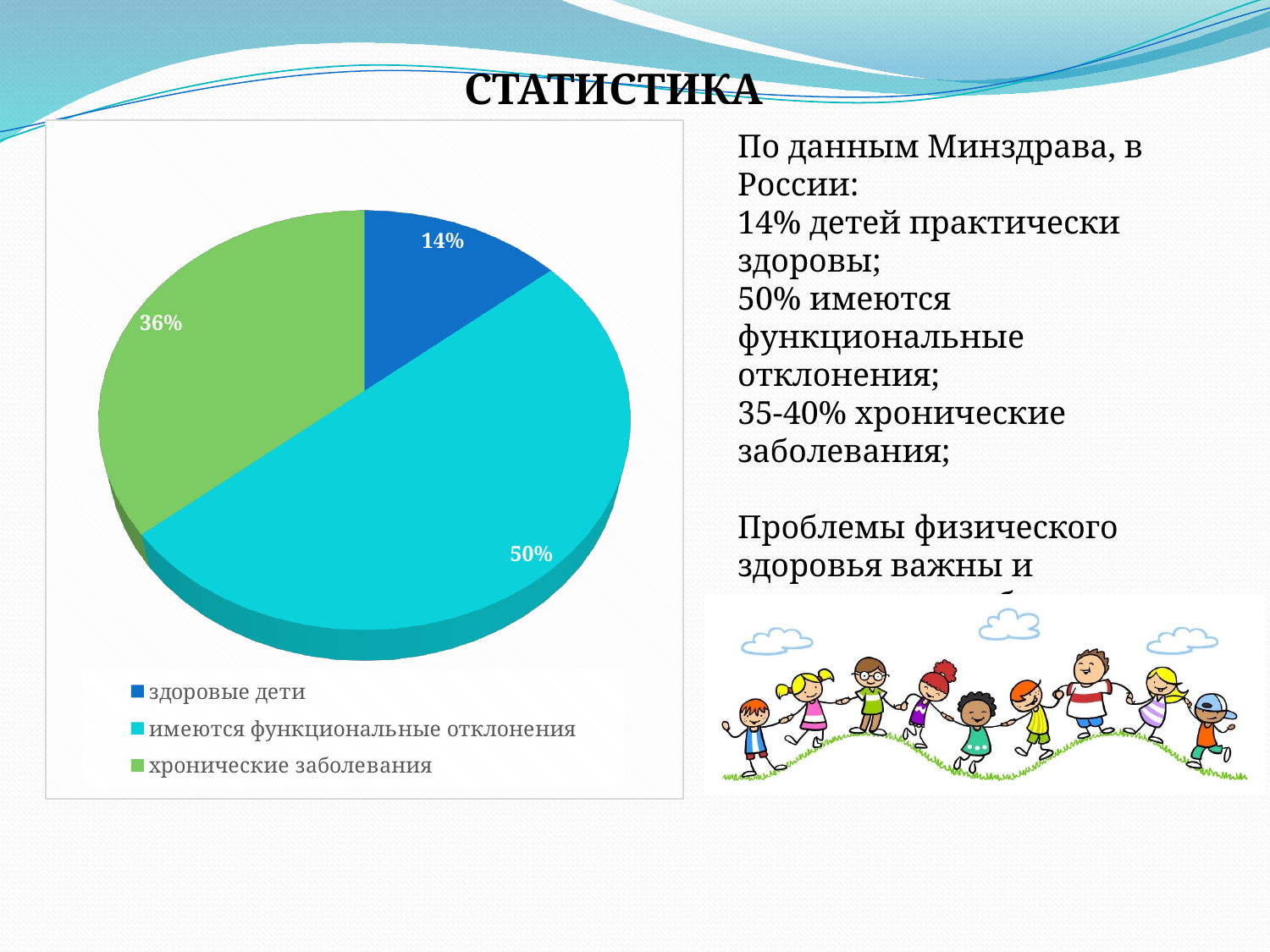
What share of the pie is labelled "имеются функциональные отклонения"? 50% Which legend entry is shown in dark blue? здоровые дети What kind of chart is shown on the slide? pie chart How many slices does the pie chart have? 3 What colour is the slice for "хронические заболевания"? green Which category has the largest slice of the pie? имеются функциональные отклонения Which is larger: the slice for "хронические заболевания" or the slice for "здоровые дети"? хронические заболевания What is the difference in percentage points between "имеются функциональные отклонения" and "хронические заболевания"? 14 What share of the pie is labelled "хронические заболевания"? 36% What is the difference in percentage points between "хронические заболевания" and "здоровые дети"? 22 Which category has the smallest slice of the pie? здоровые дети What share of the pie is labelled "здоровые дети"? 14%